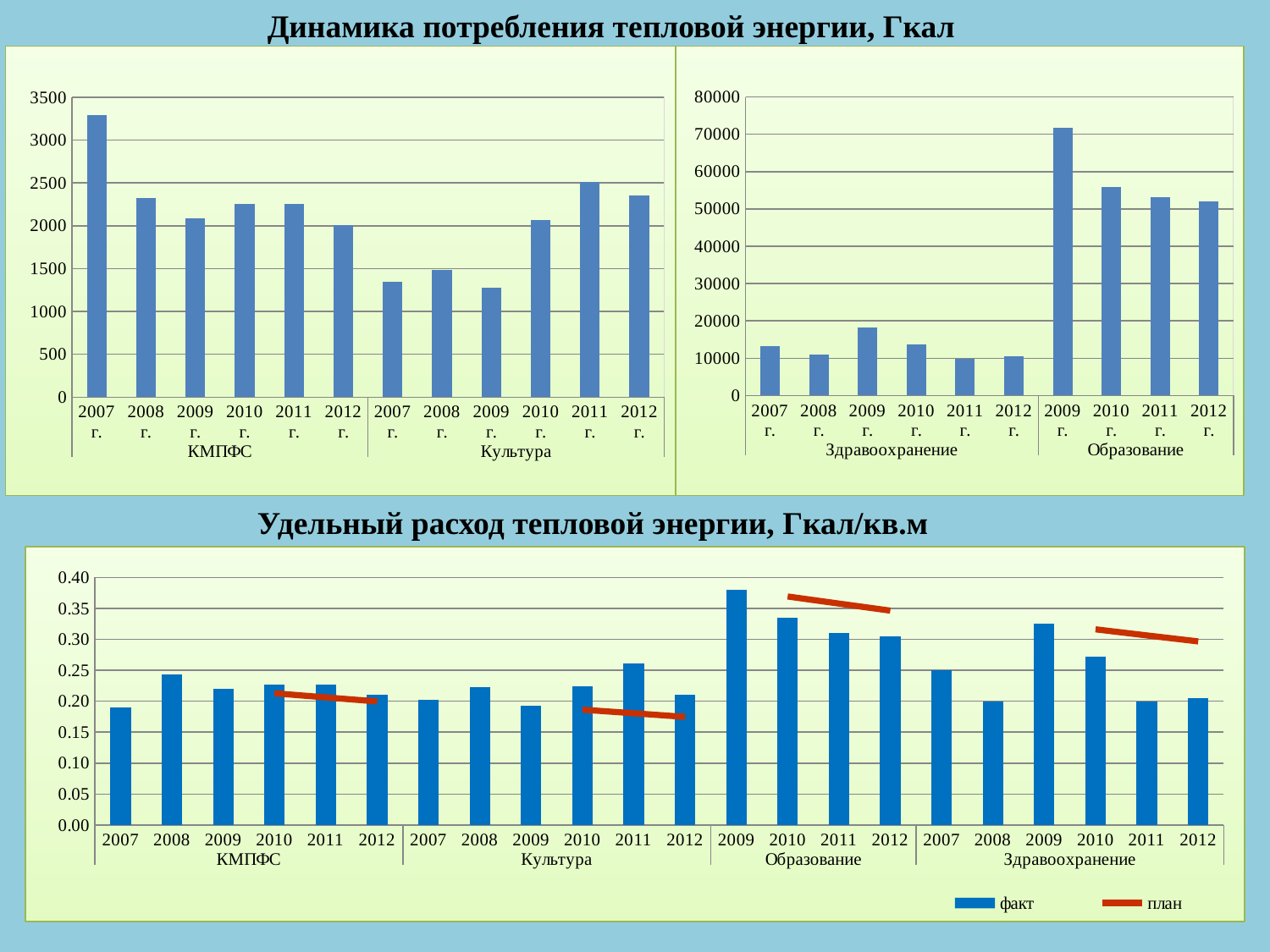
In the top-left chart (Динамика потребления тепловой энергии, Гкал), which year and group has the highest value? КМПФС, 2007 г. In the top-left chart, is the value for Культура 2009 г. greater or less than 1500? less How many series does the legend of the bottom chart list? 2 In the top-right chart, which year and group has the highest value? Образование, 2009 г. How many bars are plotted in the top-left chart? 12 In the top-left chart, is the value for КМПФС 2007 г. greater or less than 3000? greater In the bottom chart (Удельный расход тепловой энергии, Гкал/кв.м), which year and group has the highest факт value? Образование, 2009 What kind of chart is the bottom chart (Удельный расход тепловой энергии)? combination bar and line chart In the top-left chart, which year and group has the lowest value? Культура, 2009 г. In the top-right chart, is the value for Здравоохранение 2009 г. greater or less than 20000? less In the top-right chart, do the values for Образование rise or fall from 2009 to 2012? fall